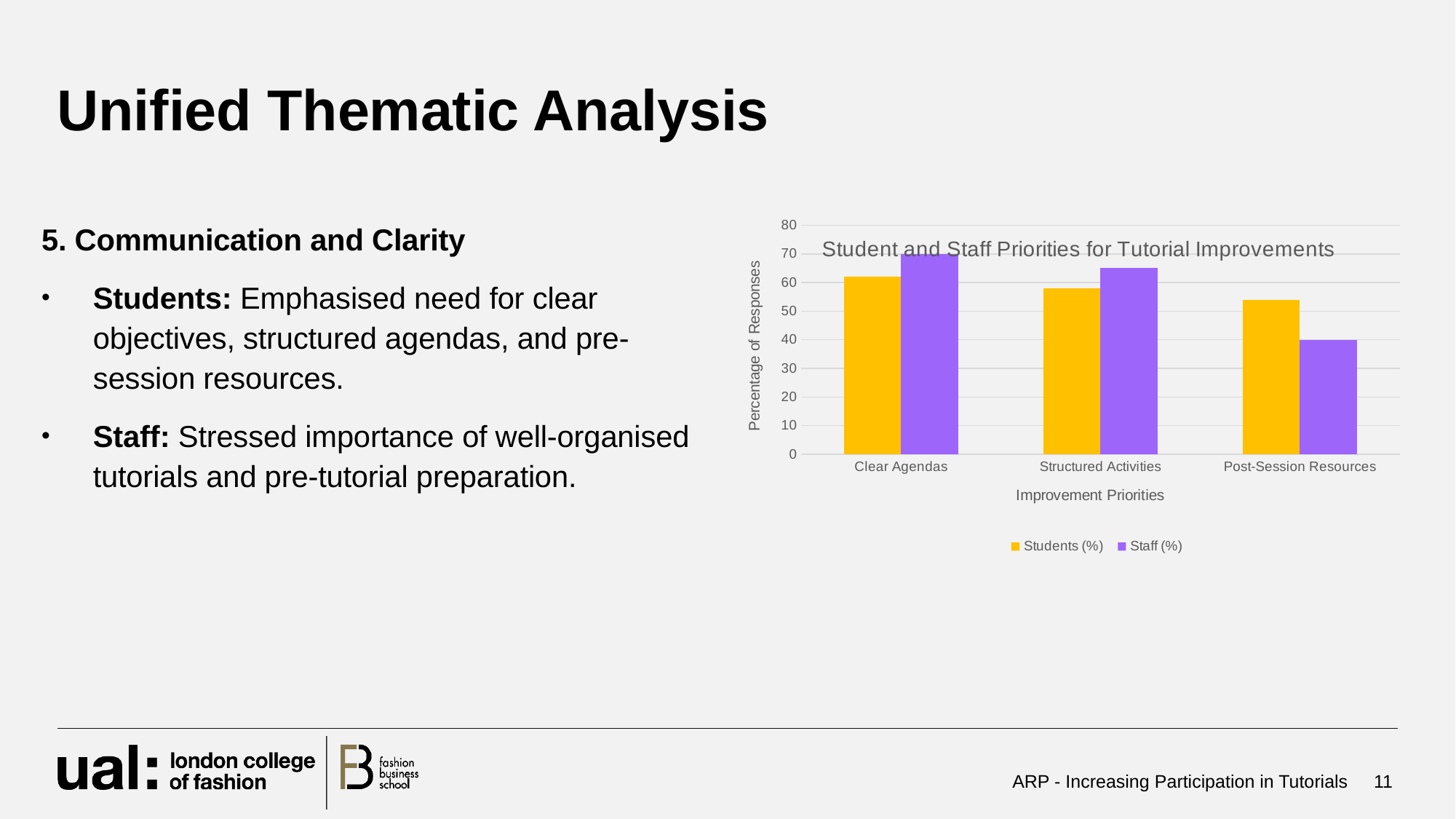
Which category has the lowest Students (%) value? Post-Session Resources Is the Staff (%) value for Post-Session Resources greater or less than 50? less How many categories are shown on the x axis of the chart? 3 Is the Students (%) value for Clear Agendas greater or less than 50? greater Which category has the lowest Staff (%) value? Post-Session Resources For Post-Session Resources, which is larger: Students (%) or Staff (%)? Students (%) What is the title of the chart? Student and Staff Priorities for Tutorial Improvements What type of chart is shown on the slide? bar chart Which category has the highest Staff (%) value? Clear Agendas For Clear Agendas, which is larger: Students (%) or Staff (%)? Staff (%) Do the Students (%) values rise or fall from Clear Agendas to Post-Session Resources? fall How many series does the chart legend list? 2